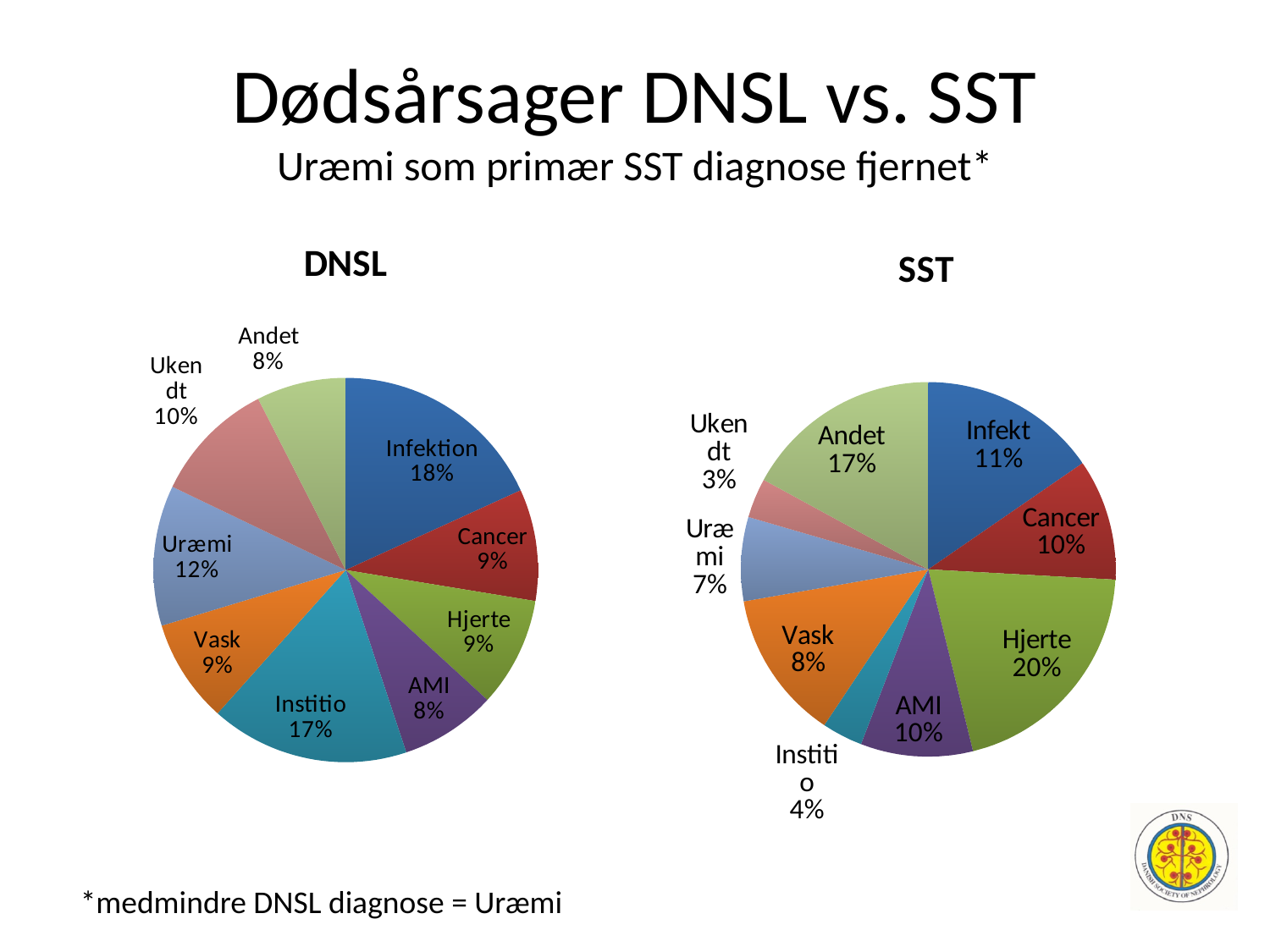
In the SST pie chart, what share does Ukendt have? 3% In the SST pie chart, what share does Hjerte have? 20% In the SST pie chart, which category has the largest share? Hjerte How many categories are shown in the DNSL pie chart? 9 In the SST pie chart, which category has the smallest share? Ukendt What is the title of the chart on the left? DNSL In the DNSL pie chart, what is the combined share of Cancer and Hjerte? 18% Which is larger: the Institio share in the DNSL chart or the Institio share in the SST chart? DNSL In the DNSL pie chart, what share does Infektion have? 18% What type of chart is used for the SST data? Pie chart What is the difference between the Hjerte share in the SST chart and the Hjerte share in the DNSL chart? 11 percentage points In the DNSL pie chart, which category has the largest share? Infektion